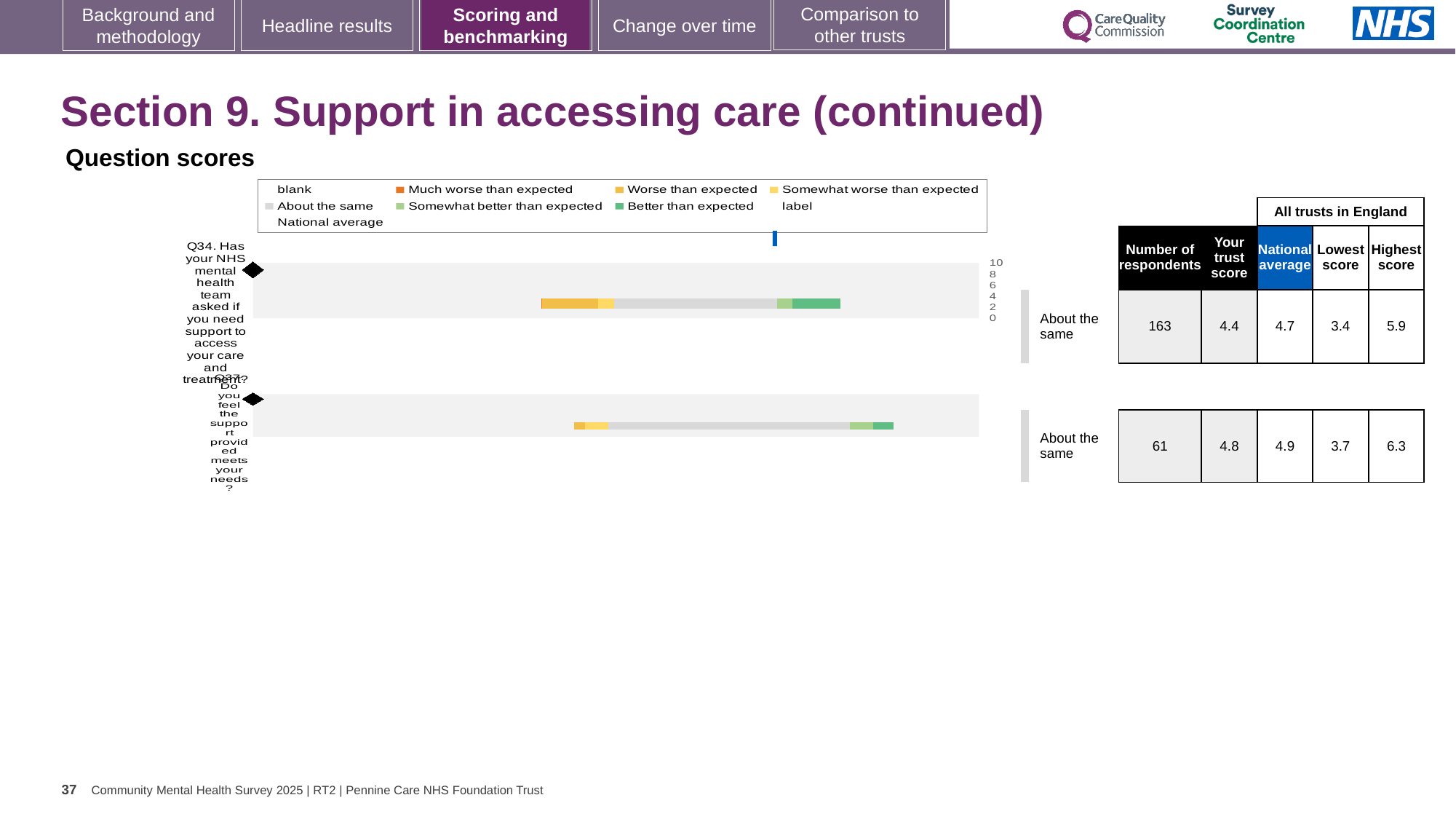
What is the difference between the highest score and the lowest score across all trusts in England for Q34? 2.5 What is the national average score for Q37 (Do you feel the support provided meets your needs)? 4.9 What kind of chart is used to show the question scores on this slide? bar chart What is the number of respondents for Q37? 61 What is the number of respondents for Q34? 163 Which question has the higher trust score, Q34 or Q37? Q37 What is the highest score across all trusts in England for Q37? 6.3 What is the highest tick value shown on the chart's score axis? 10 What is the trust's score for Q34? 4.4 How many survey questions are plotted in the question scores chart? 2 What benchmark category is shown for Q34 (Has your NHS mental health team asked if you need support to access your care and treatment)? About the same In the chart legend, which colour represents 'Better than expected'? green